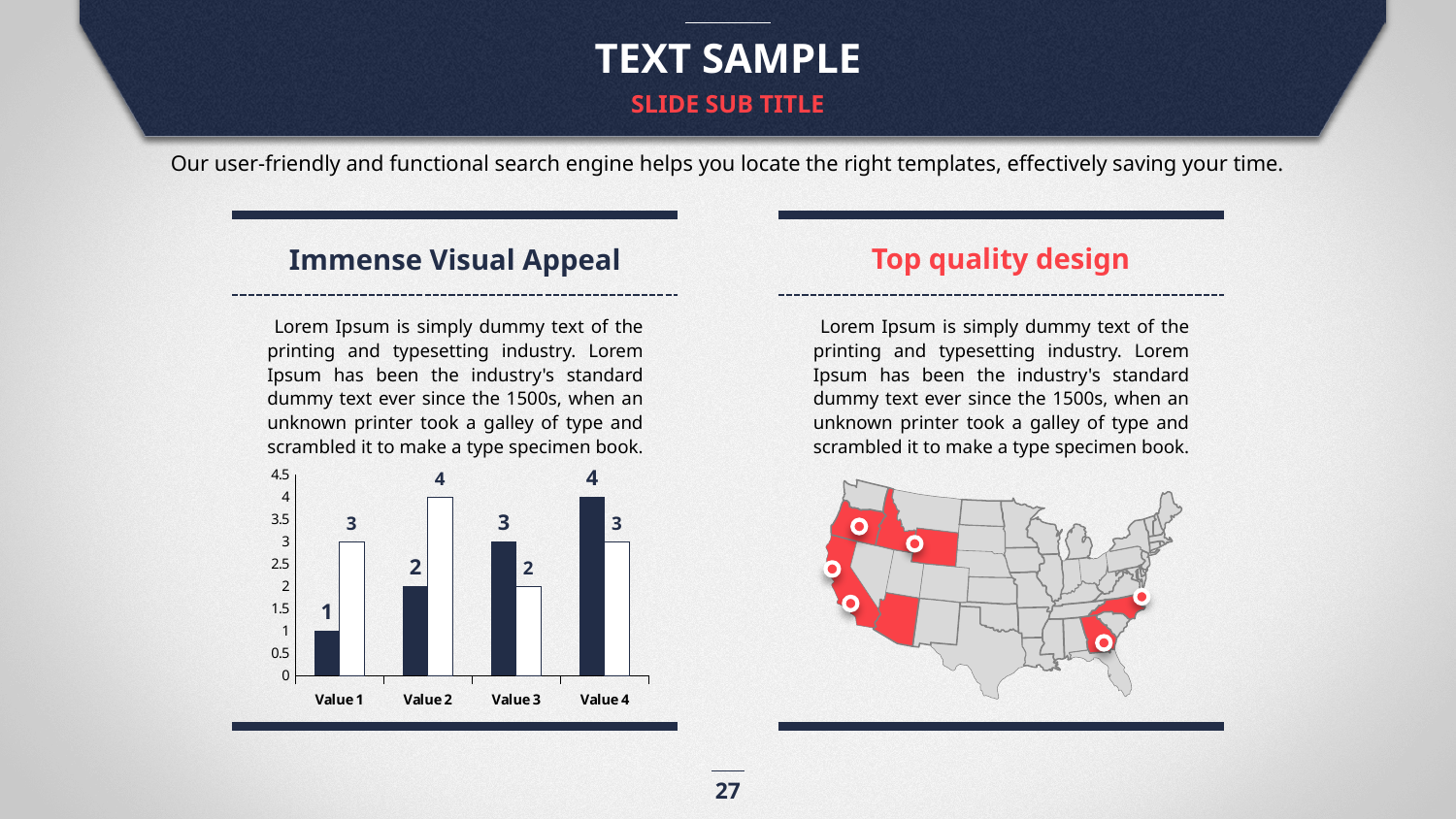
How many categories are shown on the x axis of the bar chart? 4 Which category has the highest white bar? Value 2 Do the dark navy bars rise or fall from Value 1 to Value 4? rise What is the value of the dark navy bar for Value 1? 1 What is the value of the dark navy bar for Value 4? 4 What is the difference between the white bar and the dark navy bar for Value 1? 2 What type of chart is shown on the slide? bar chart For Value 3, which is larger, the dark navy bar or the white bar? the dark navy bar What is the maximum value shown on the y axis of the bar chart? 4.5 What is the value of the white bar for Value 3? 2 What is the value of the white bar for Value 2? 4 Which category has the lowest dark navy bar? Value 1